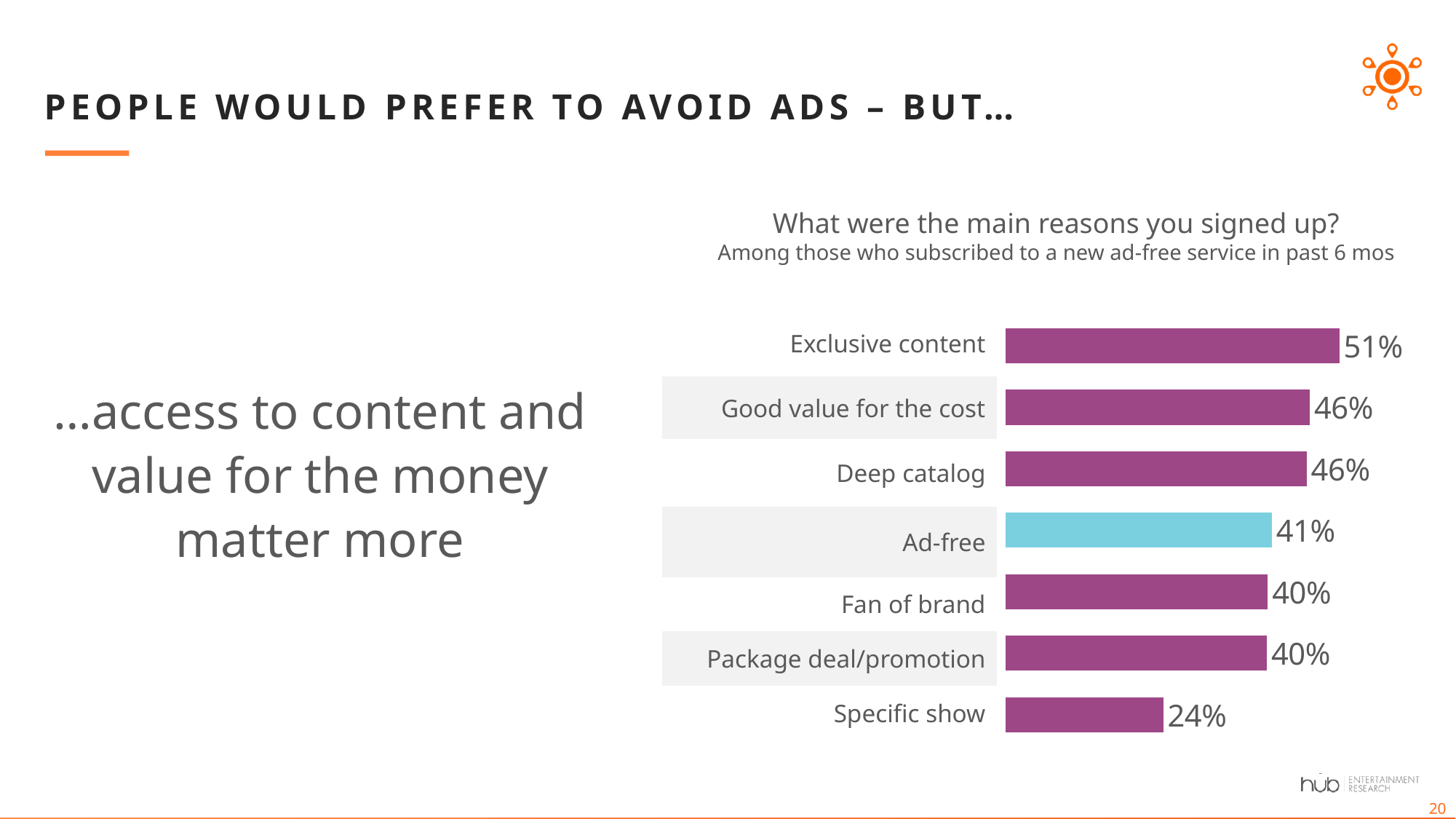
Which bar is shown in a different colour (blue) from the others? Ad-free What is the difference in percentage points between Good value for the cost and Specific show? 22 What is the difference in percentage points between Exclusive content and Ad-free? 10 What is the value shown for Specific show? 24% What is the value shown for Package deal/promotion? 40% How many reasons (categories) are shown in the chart? 7 Which is larger, the value for Deep catalog or the value for Fan of brand? Deep catalog Which reason has the highest percentage? Exclusive content Which reason has the lowest percentage? Specific show What type of chart is shown on the slide? Bar chart What is the value shown for Ad-free? 41% What percentage of respondents cited Exclusive content as a main reason for signing up? 51%